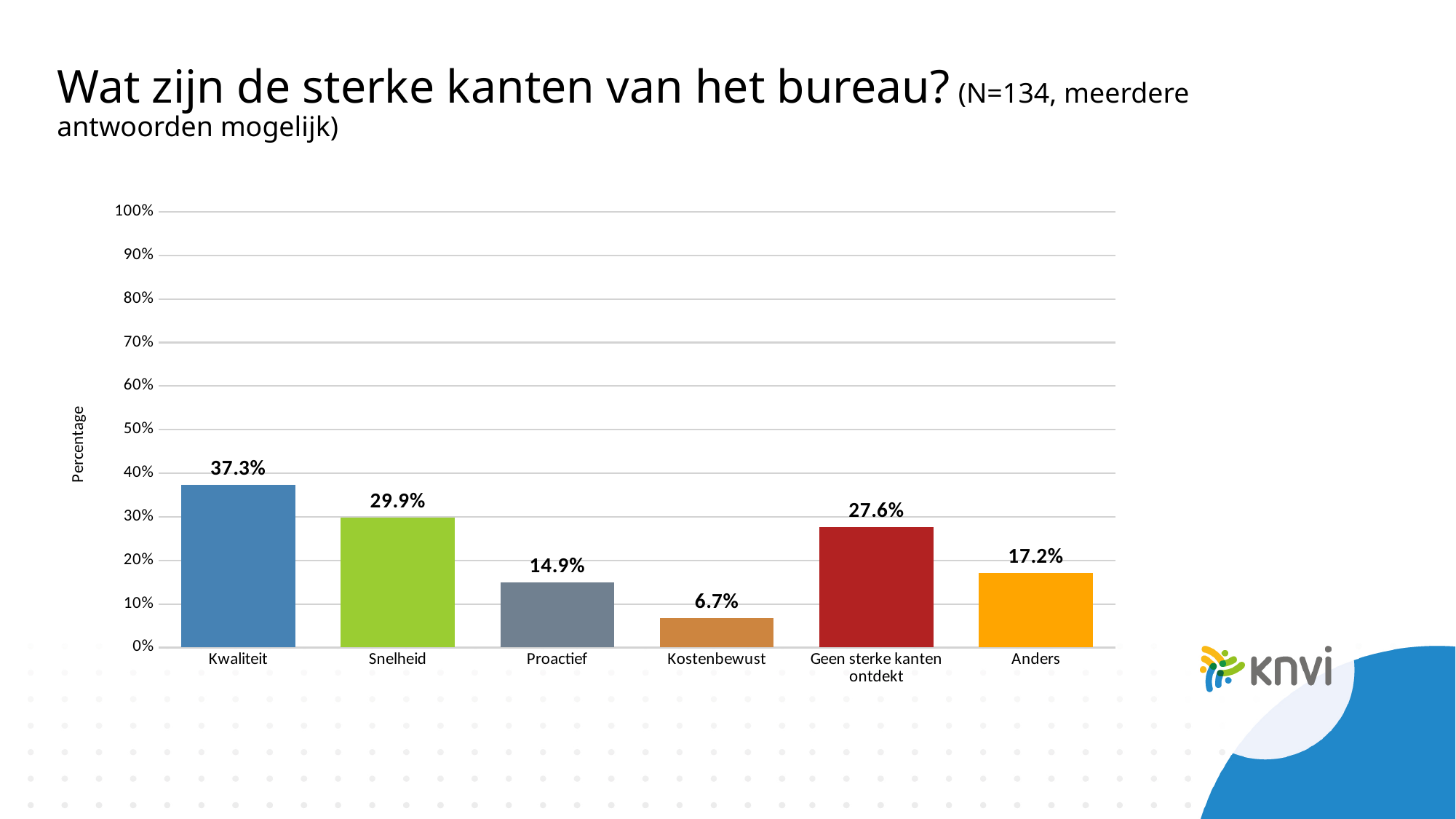
What kind of chart is shown on the slide? bar chart What is the difference between Anders and Proactief? 2.3% Which is larger, Snelheid or Geen sterke kanten ontdekt? Snelheid How many categories are shown in the chart? 6 Which category has the highest value? Kwaliteit What is the value for Kostenbewust? 6.7% What is the value for Geen sterke kanten ontdekt? 27.6% Is the value for Proactief greater or less than 20%? less What is the label of the vertical axis? Percentage What is the difference between Kwaliteit and Snelheid? 7.4% Which category has the lowest value? Kostenbewust What is the value for Kwaliteit? 37.3%